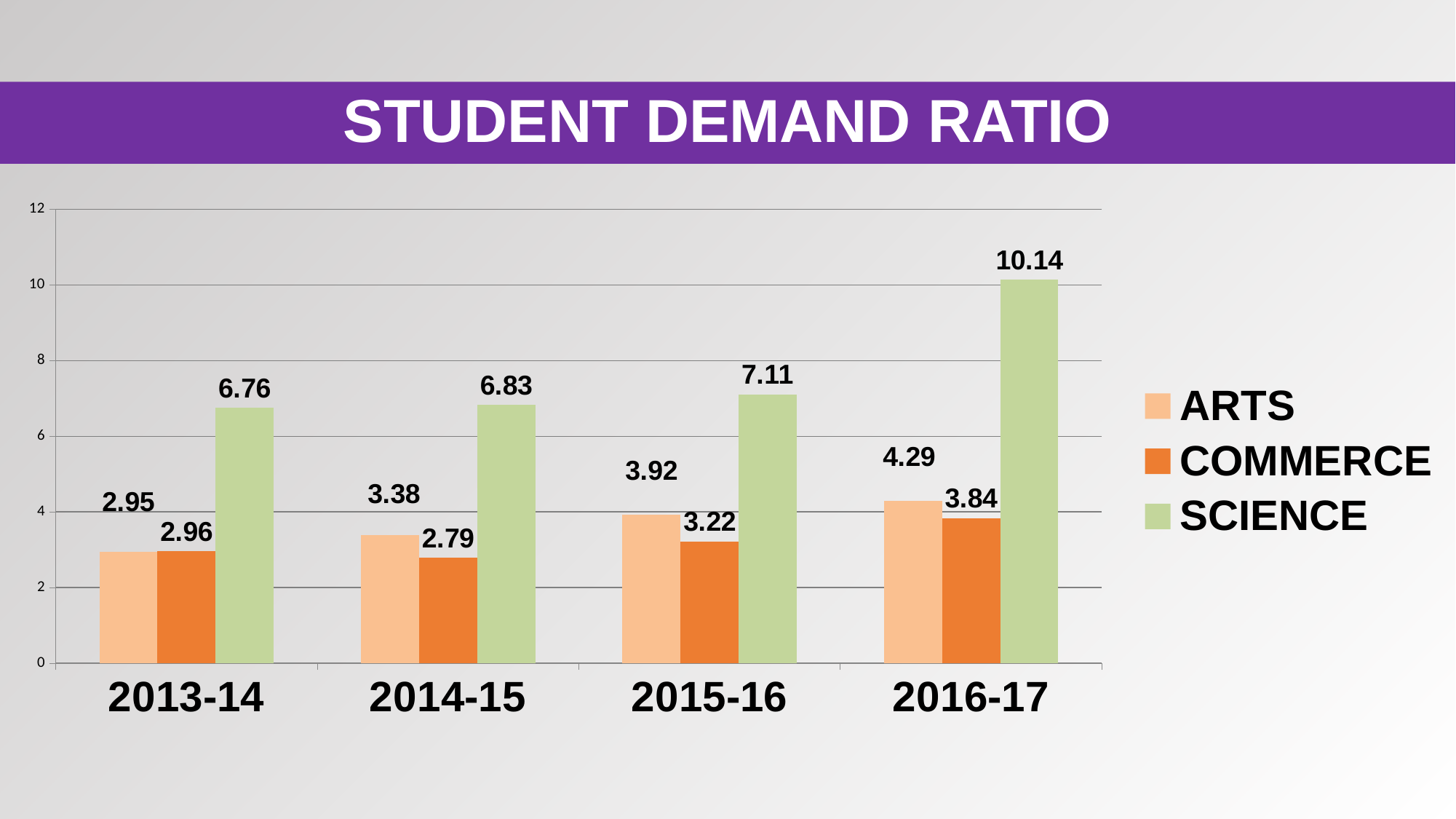
How many years are shown on the x axis? 4 In which year is the COMMERCE value lowest? 2014-15 What kind of chart is shown on the slide? bar chart What is the difference between the SCIENCE value in 2016-17 and the SCIENCE value in 2015-16? 3.03 How many series does the legend list? 3 What is the value for ARTS in 2014-15? 3.38 Which is larger in 2014-15, ARTS or COMMERCE? ARTS Is the value for SCIENCE in 2016-17 greater or less than 10? greater In which year is the SCIENCE value highest? 2016-17 Does the ARTS value rise or fall from 2013-14 to 2016-17? rise What is the value for COMMERCE in 2015-16? 3.22 What is the value for SCIENCE in 2016-17? 10.14